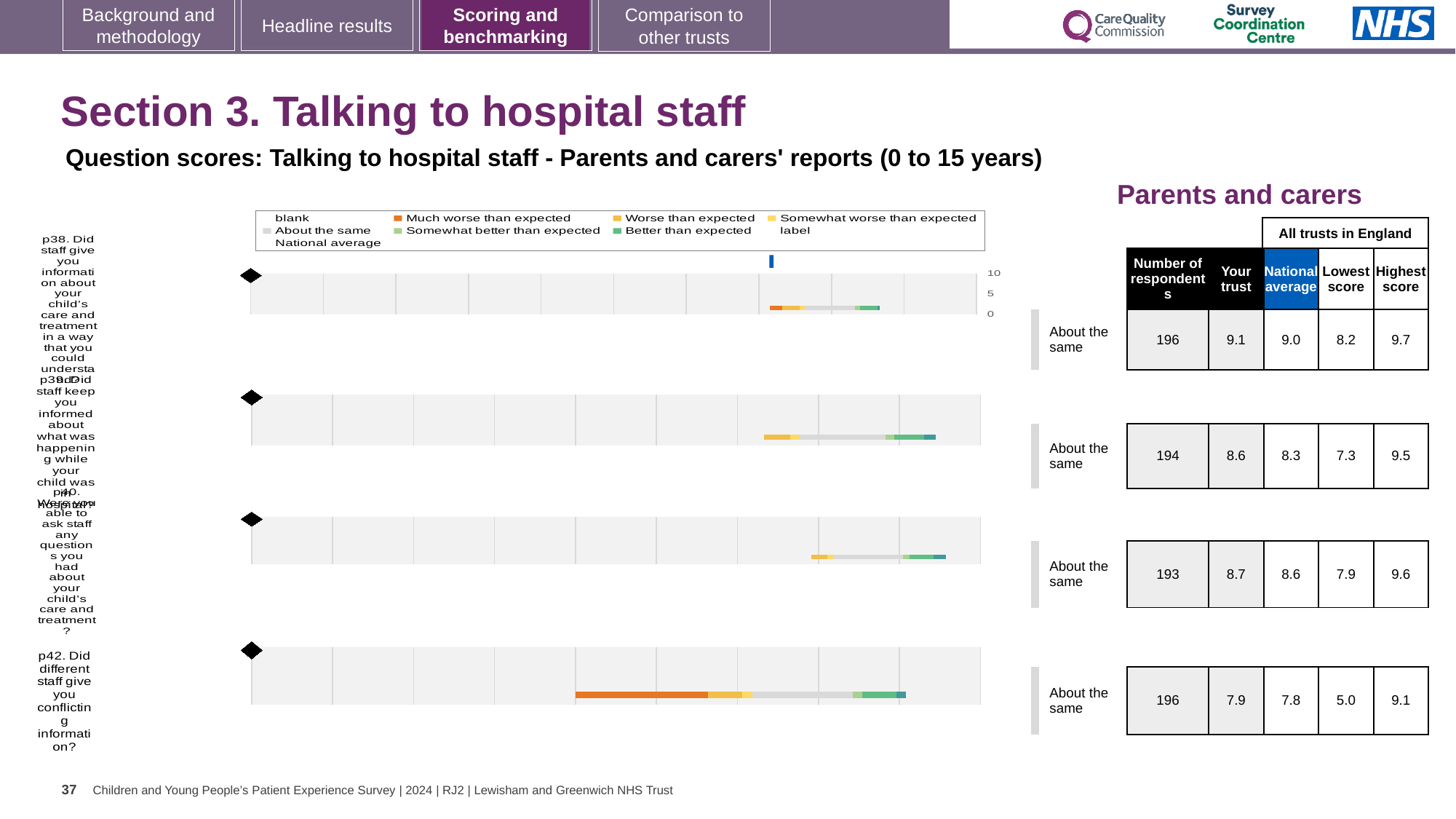
For p42, what is the difference between the highest score (9.1) and the lowest score (5.0)? 4.1 In the legend, what colour represents 'Much worse than expected'? orange What kind of chart is used to show the p38 question results? bar chart In the legend, what colour represents 'Better than expected'? green How many entries does the shared legend above the charts list? 9 Which question's chart has the largest orange 'Much worse than expected' segment? p42 In the table beside the p42 chart, what is the lowest score among all trusts in England? 5.0 How many question charts (p38, p39, p40, p42) are shown on the slide? 4 In the table beside the p39 chart, what is the 'Your trust' score? 8.6 Which question has the lowest 'Your trust' score in the tables? p42 In the table beside the p38 chart, what is the number of respondents? 196 For p38, which is larger: the 'Your trust' score or the 'National average'? Your trust